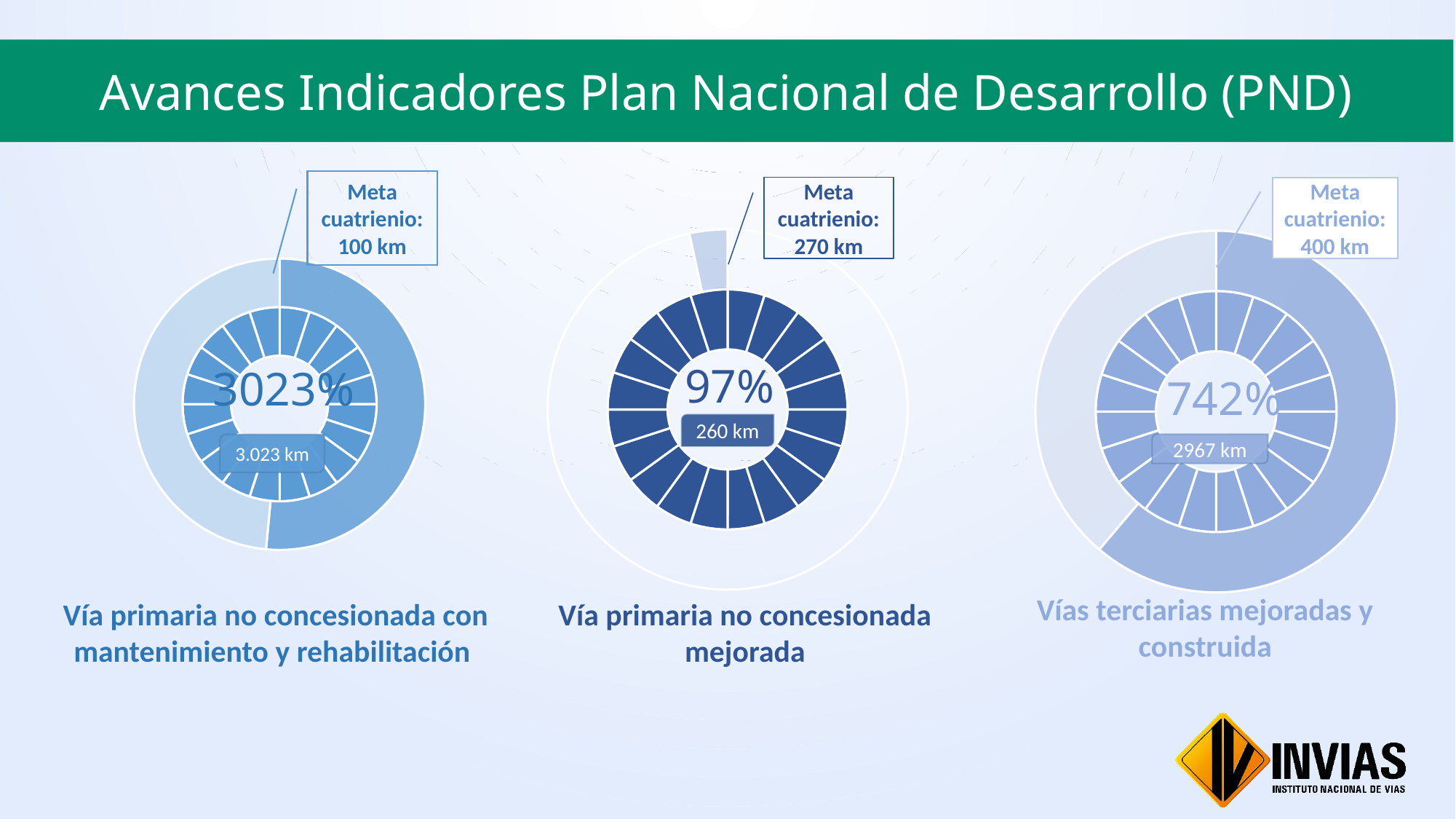
What percentage is shown in the centre of the chart for 'Vía primaria no concesionada con mantenimiento y rehabilitación'? 3023% What is the 'Meta cuatrienio' for the chart 'Vía primaria no concesionada mejorada'? 270 km What percentage is shown in the centre of the chart for 'Vías terciarias mejoradas y construida'? 742% What is the title of the slide containing the three charts? Avances Indicadores Plan Nacional de Desarrollo (PND) Which of the three charts shows the lowest percentage? Vía primaria no concesionada mejorada For the chart 'Vía primaria no concesionada mejorada', what is the difference between the 'Meta cuatrienio' and the km achieved? 10 km What percentage is shown in the centre of the chart for 'Vía primaria no concesionada mejorada'? 97% Which of the three charts shows the highest percentage? Vía primaria no concesionada con mantenimiento y rehabilitación Which is larger: the 'Meta cuatrienio' for 'Vías terciarias mejoradas y construida' or the 'Meta cuatrienio' for 'Vía primaria no concesionada mejorada'? Vías terciarias mejoradas y construida How many km are shown in the centre of the chart for 'Vías terciarias mejoradas y construida'? 2967 km How many km are shown in the centre of the chart for 'Vía primaria no concesionada con mantenimiento y rehabilitación'? 3.023 km What is the 'Meta cuatrienio' for the chart 'Vías terciarias mejoradas y construida'? 400 km